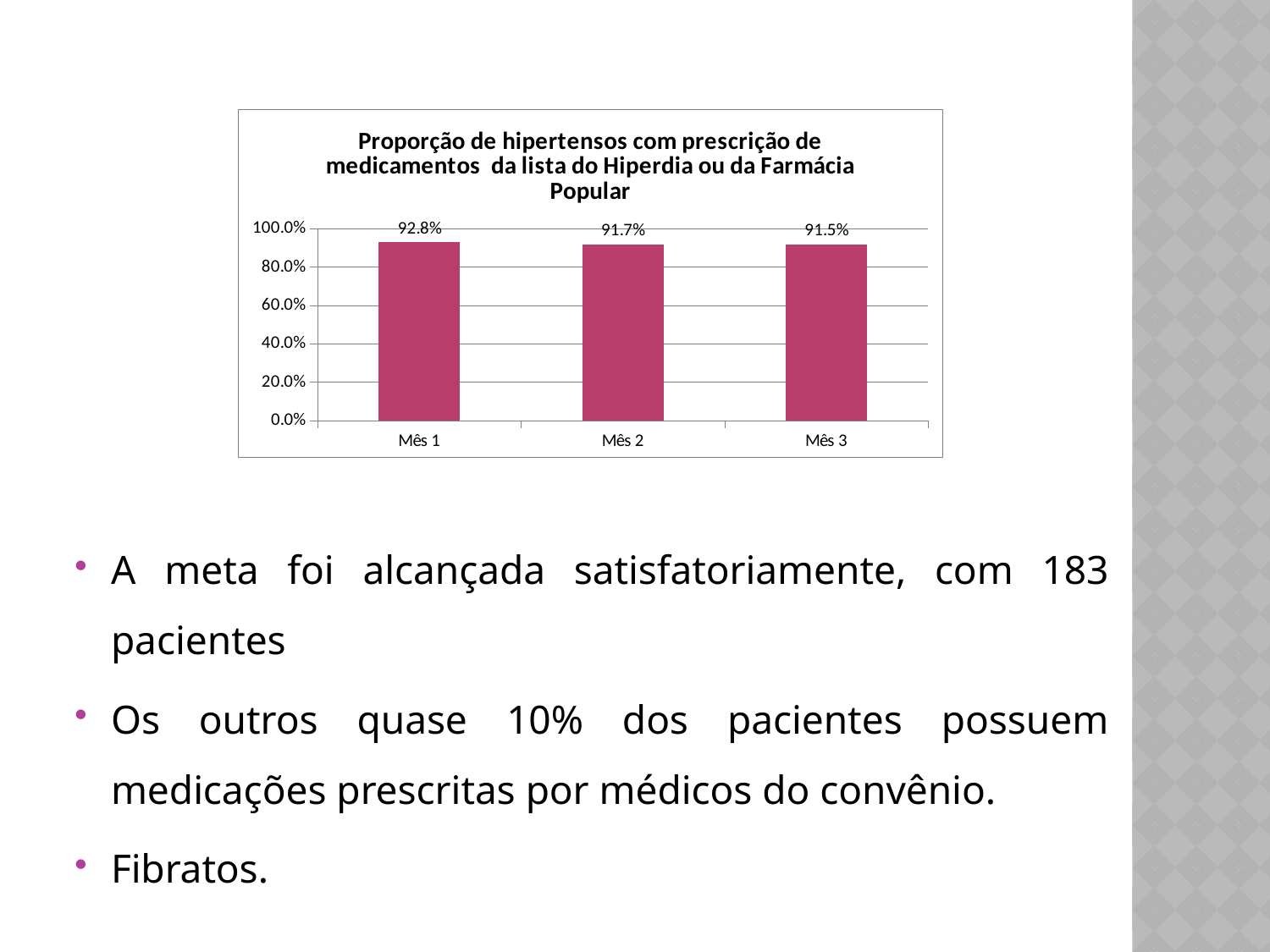
What is the value for Mês 1? 92.8% What is the difference between the values for Mês 1 and Mês 3? 1.3% How many months are shown on the x axis? 3 Do the values rise or fall from Mês 1 to Mês 3? fall What is the value for Mês 2? 91.7% Is the value for Mês 2 greater or less than 80.0%? greater Which month has the highest proportion? Mês 1 Which is larger, the value for Mês 1 or the value for Mês 2? Mês 1 Which month has the lowest proportion? Mês 3 What kind of chart is shown on the slide? bar chart What is the title of the chart? Proporção de hipertensos com prescrição de medicamentos da lista do Hiperdia ou da Farmácia Popular What is the value for Mês 3? 91.5%